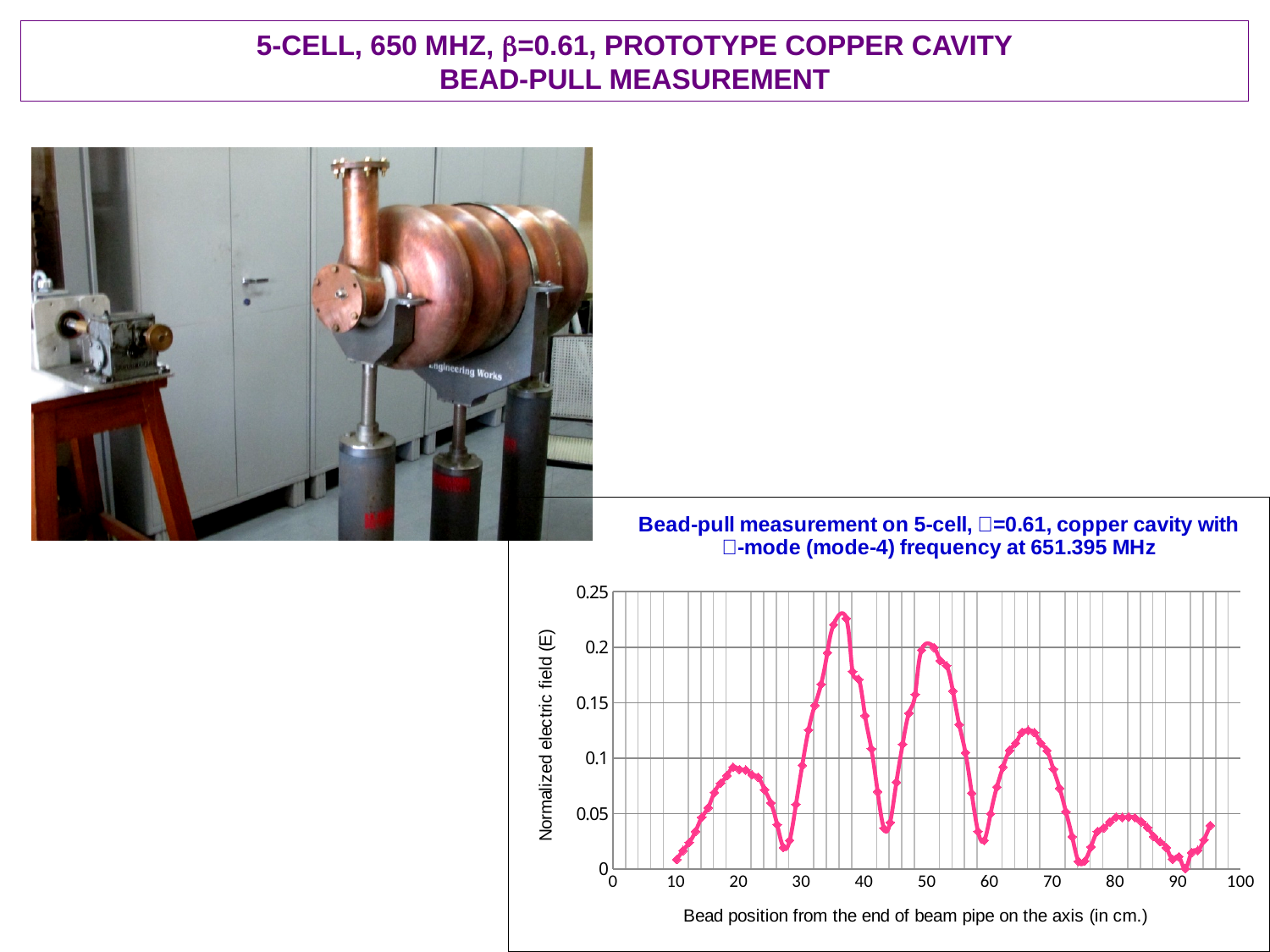
Is the value of the curve at the peak near 20 cm greater or less than 0.05? greater What is the label of the y axis of the chart? Normalized electric field (E) Is the value of the curve at the peak near 66 cm greater or less than 0.15? less Which is larger: the peak of the curve near 36 cm or the peak near 82 cm? the peak near 36 cm Do the peak heights rise or fall going from the peak near 36 cm to the peak near 82 cm? fall Which peak of the curve is the highest: the one near 20 cm, near 36 cm, near 50 cm, near 66 cm, or near 82 cm? near 36 cm What is the maximum value shown on the y axis of the chart? 0.25 Is the value of the curve at its highest peak (near 36 cm) greater or less than 0.2? greater What is the label of the x axis of the chart? Bead position from the end of beam pipe on the axis (in cm.) What kind of chart is shown on the slide? line chart How many peaks (local maxima) does the plotted curve show? 5